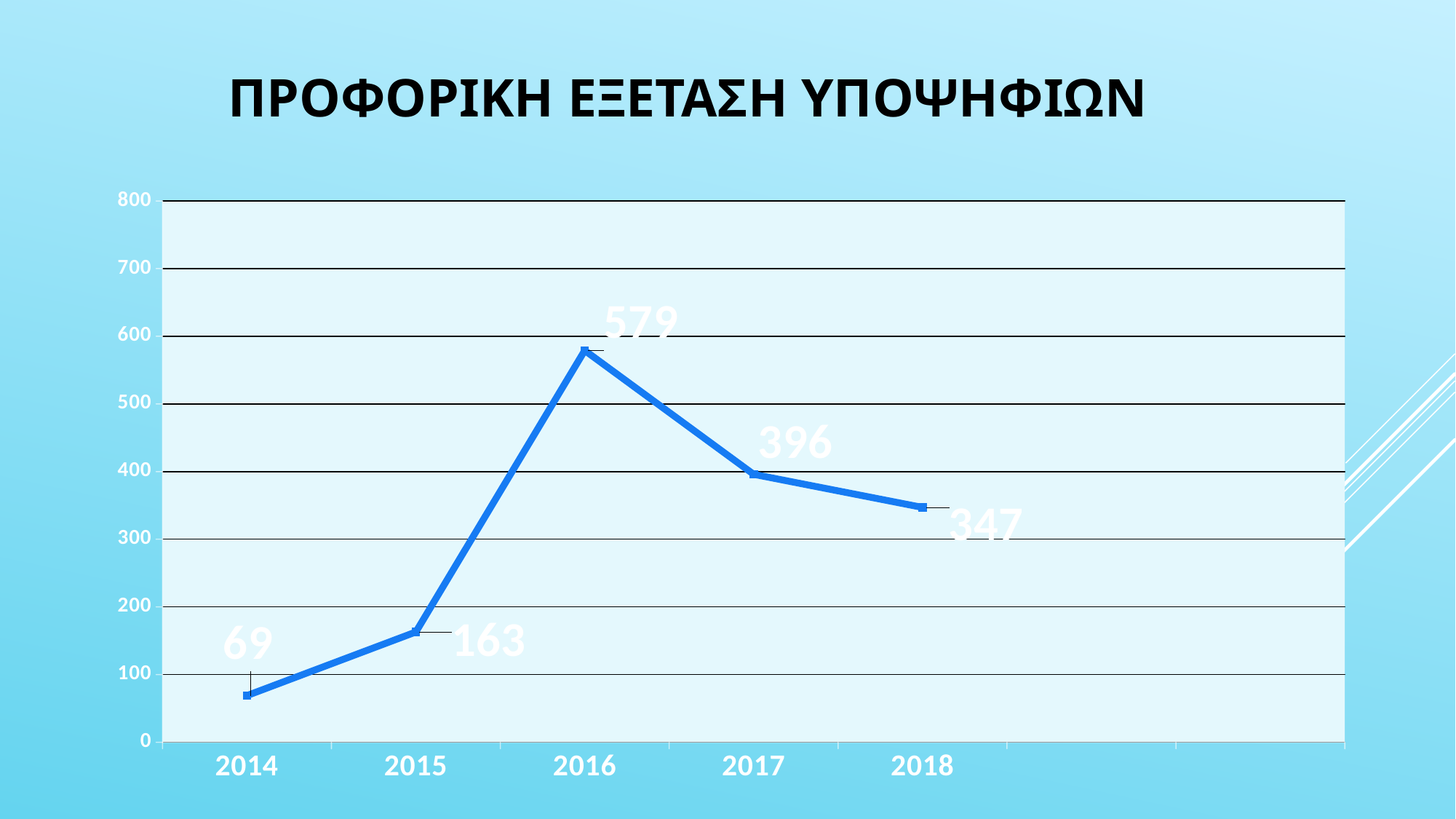
What is the value for 2016? 579 What is the difference between the values for 2015 and 2014? 94 Which year has the highest value? 2016 Which year has the lowest value? 2014 What is the value for 2018? 347 What kind of chart is shown on the slide? line chart Is the value for 2015 greater or less than 200? less Which is larger, the value for 2017 or the value for 2018? 2017 What is the value for 2014? 69 How many years are plotted on the chart? 5 Do the values rise or fall from 2016 to 2018? fall What is the difference between the values for 2016 and 2017? 183